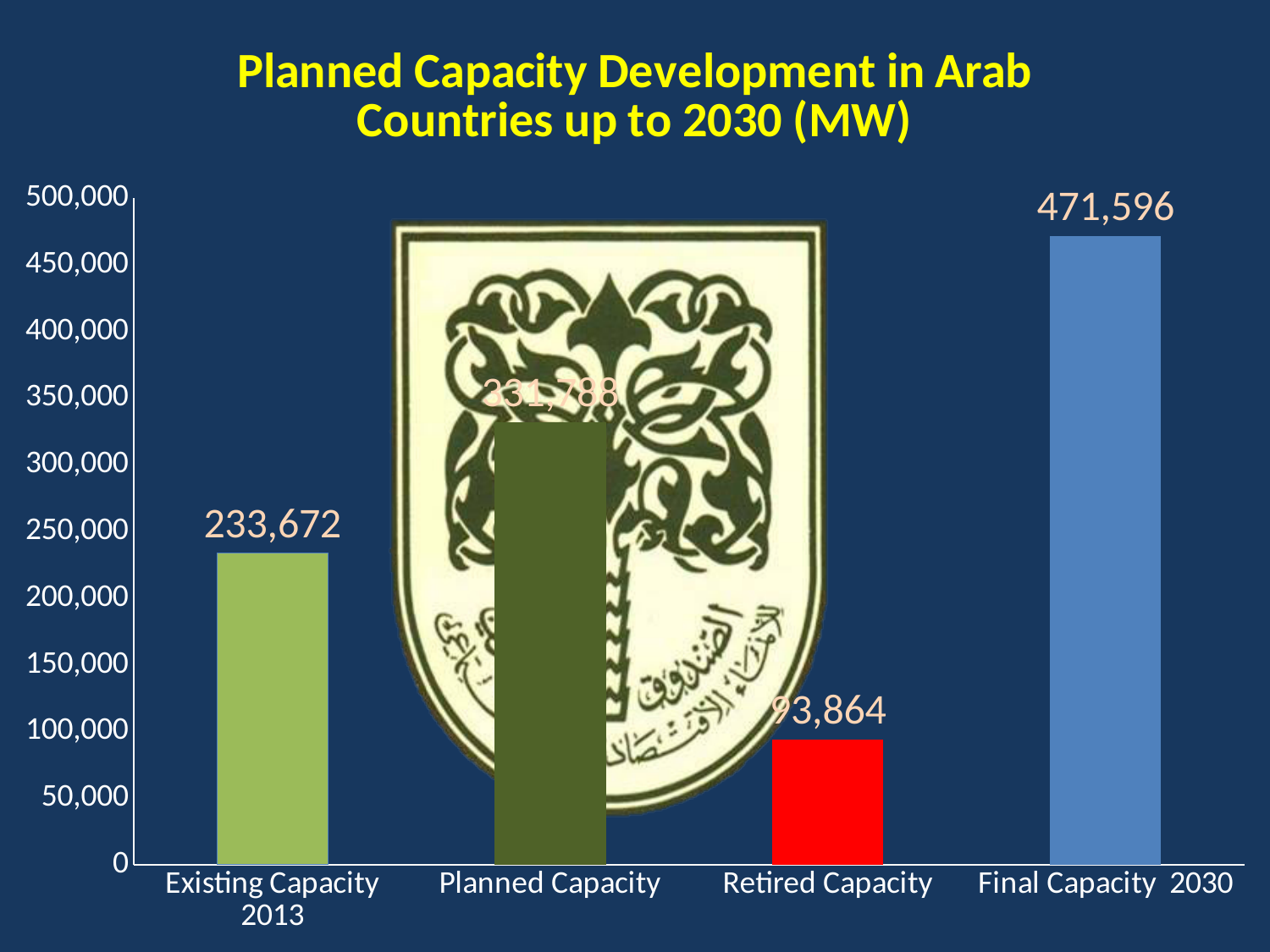
How many categories are shown in the chart? 4 Which is larger, Planned Capacity or Existing Capacity 2013? Planned Capacity What is the value for Planned Capacity? 331,788 What is the title of the chart? Planned Capacity Development in Arab Countries up to 2030 (MW) What kind of chart is shown on the slide? bar chart What is the value for Retired Capacity? 93,864 Which category has the highest value? Final Capacity 2030 What is the difference between Final Capacity 2030 and Existing Capacity 2013? 237,924 Which category has the lowest value? Retired Capacity What is the value for Final Capacity 2030? 471,596 Is the value for Retired Capacity greater or less than 100,000? less What is the value for Existing Capacity 2013? 233,672